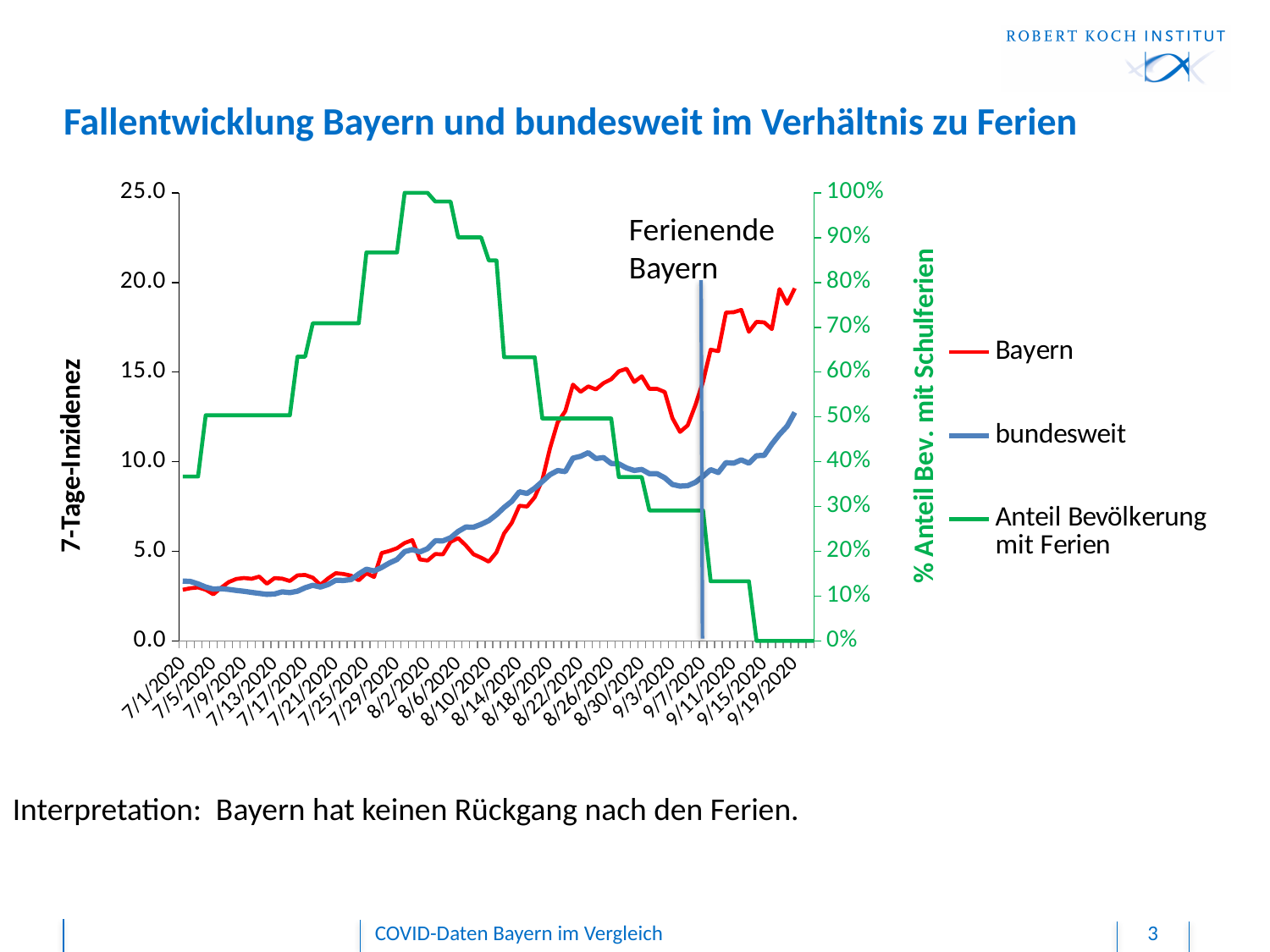
What is the highest value reached by the Anteil Bevölkerung mit Ferien line? 100% Is the value for bundesweit on 7/13/2020 greater or less than 5.0? less Is the value for Anteil Bevölkerung mit Ferien on 9/7/2020 greater or less than 50%? less On 9/19/2020, which is larger, the value for Bayern or for bundesweit? Bayern How many series does the legend list? 3 Is the value for Bayern on 9/19/2020 greater or less than 15.0? greater What is the title of the chart? Fallentwicklung Bayern und bundesweit im Verhältnis zu Ferien Does the bundesweit line rise or fall overall from 7/1/2020 to 9/19/2020? rise What label is shown on the left vertical axis? 7-Tage-Inzidenez What kind of chart is shown on the slide? line chart What is the value of Anteil Bevölkerung mit Ferien on 9/19/2020? 0%